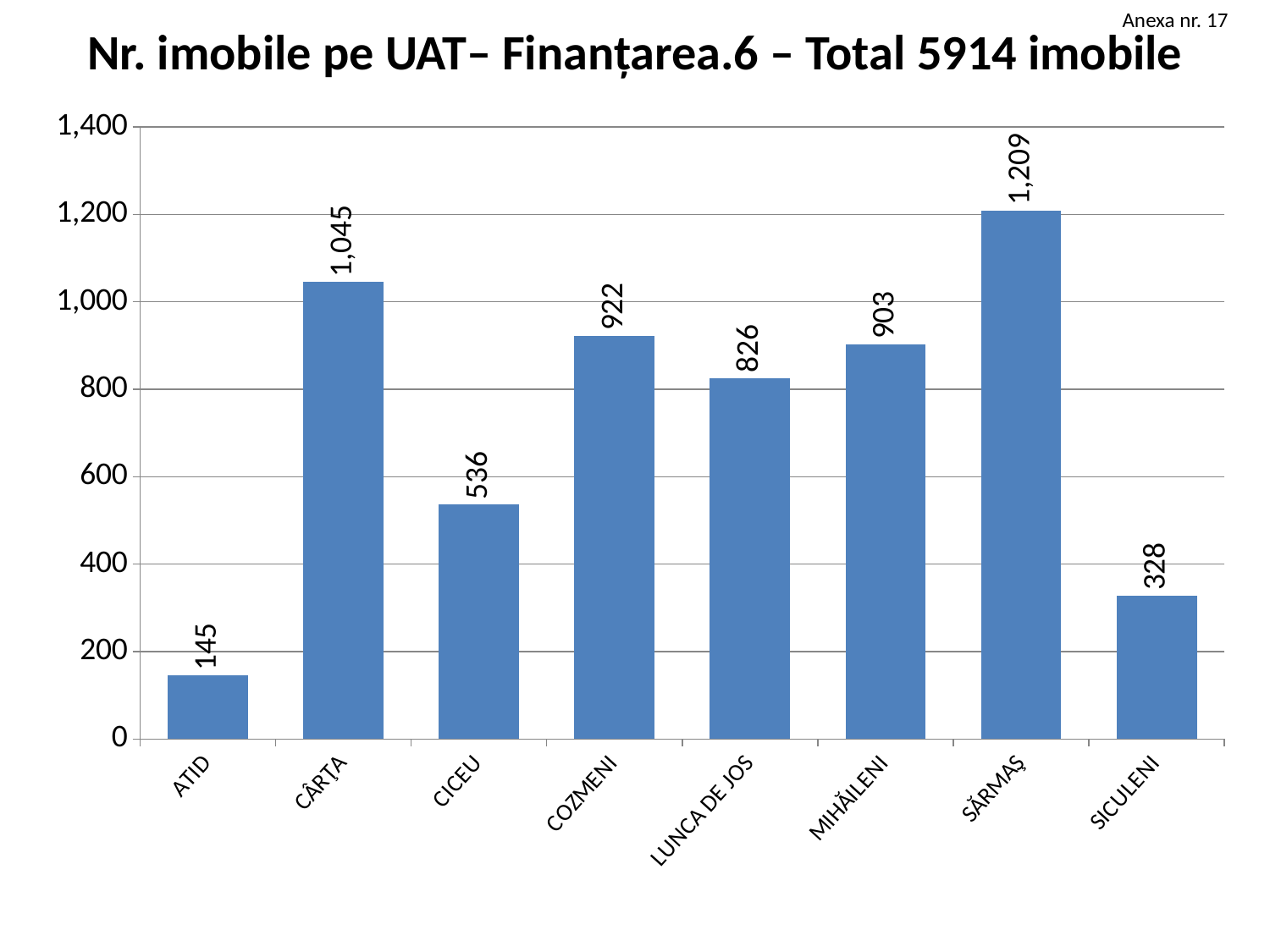
What is the value for SICULENI? 328 What is the value for CÂRȚA? 1,045 What is the value for LUNCA DE JOS? 826 What is the difference between the values for SĂRMAȘ and CÂRȚA? 164 What kind of chart is shown on the slide? bar chart How many categories are shown on the x axis? 8 What is the title of the chart? Nr. imobile pe UAT– Finanțarea.6 – Total 5914 imobile Is the value for CICEU greater or less than 600? less What is the difference between the values for CICEU and SICULENI? 208 Which is larger, the value for COZMENI or the value for MIHĂILENI? COZMENI Which category has the lowest value? ATID Which category has the highest value? SĂRMAȘ